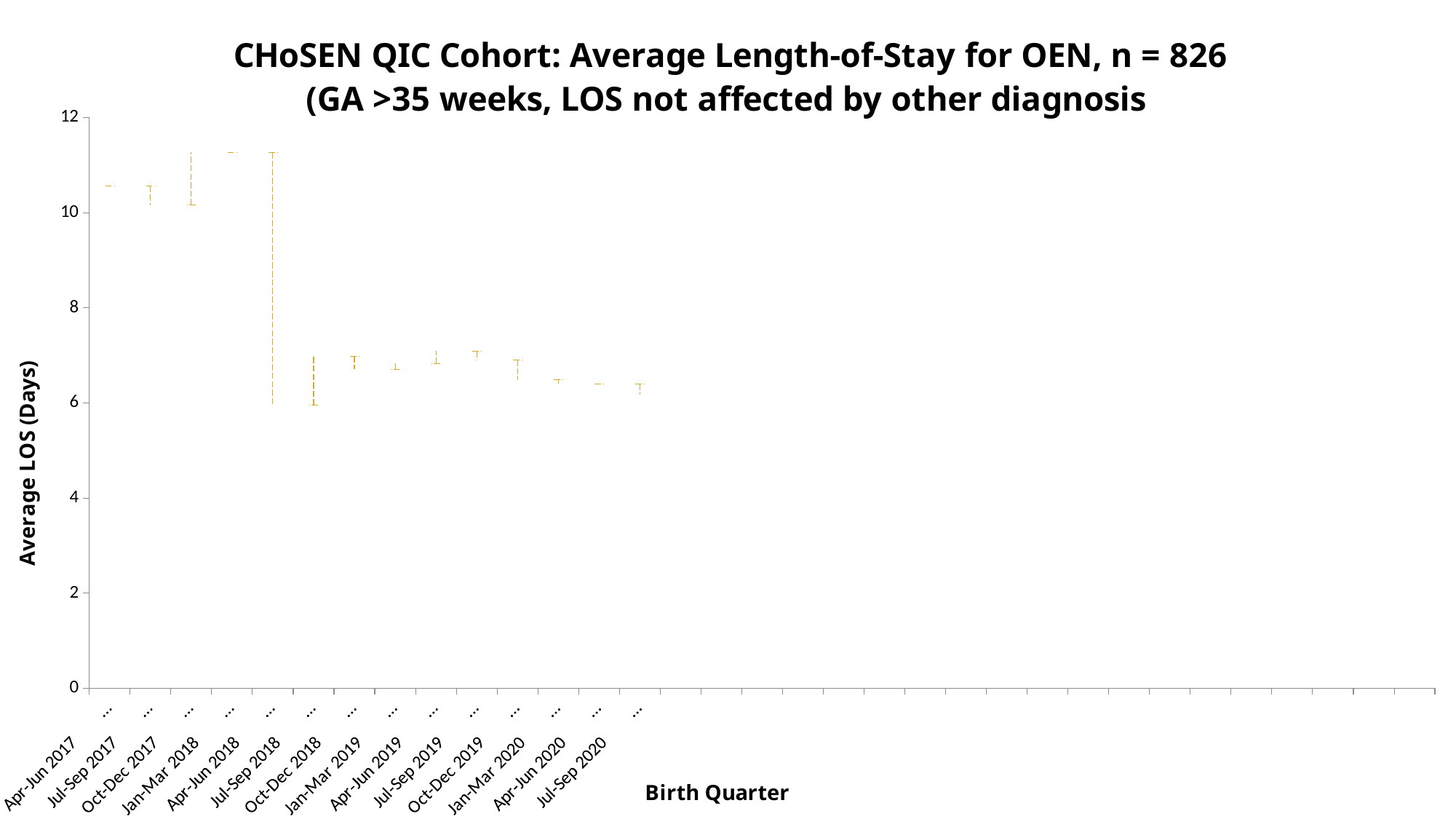
What is the highest value shown on the vertical axis? 12 How many birth quarters are labelled on the x axis? 14 Is the value for Jan-Mar 2020 greater or less than 8? less Is the value for Jan-Mar 2018 greater or less than 10? greater Which is larger, the value for Apr-Jun 2017 or the value for Apr-Jun 2020? Apr-Jun 2017 What is the label of the vertical axis? Average LOS (Days) Is the value for Apr-Jun 2017 greater or less than 10? greater Which is larger, the value for Jan-Mar 2018 or the value for Jul-Sep 2020? Jan-Mar 2018 What is the title of the chart? CHoSEN QIC Cohort: Average Length-of-Stay for OEN, n = 826 (GA >35 weeks, LOS not affected by other diagnosis Do the average LOS values generally rise or fall from Apr-Jun 2017 to Jul-Sep 2020? fall